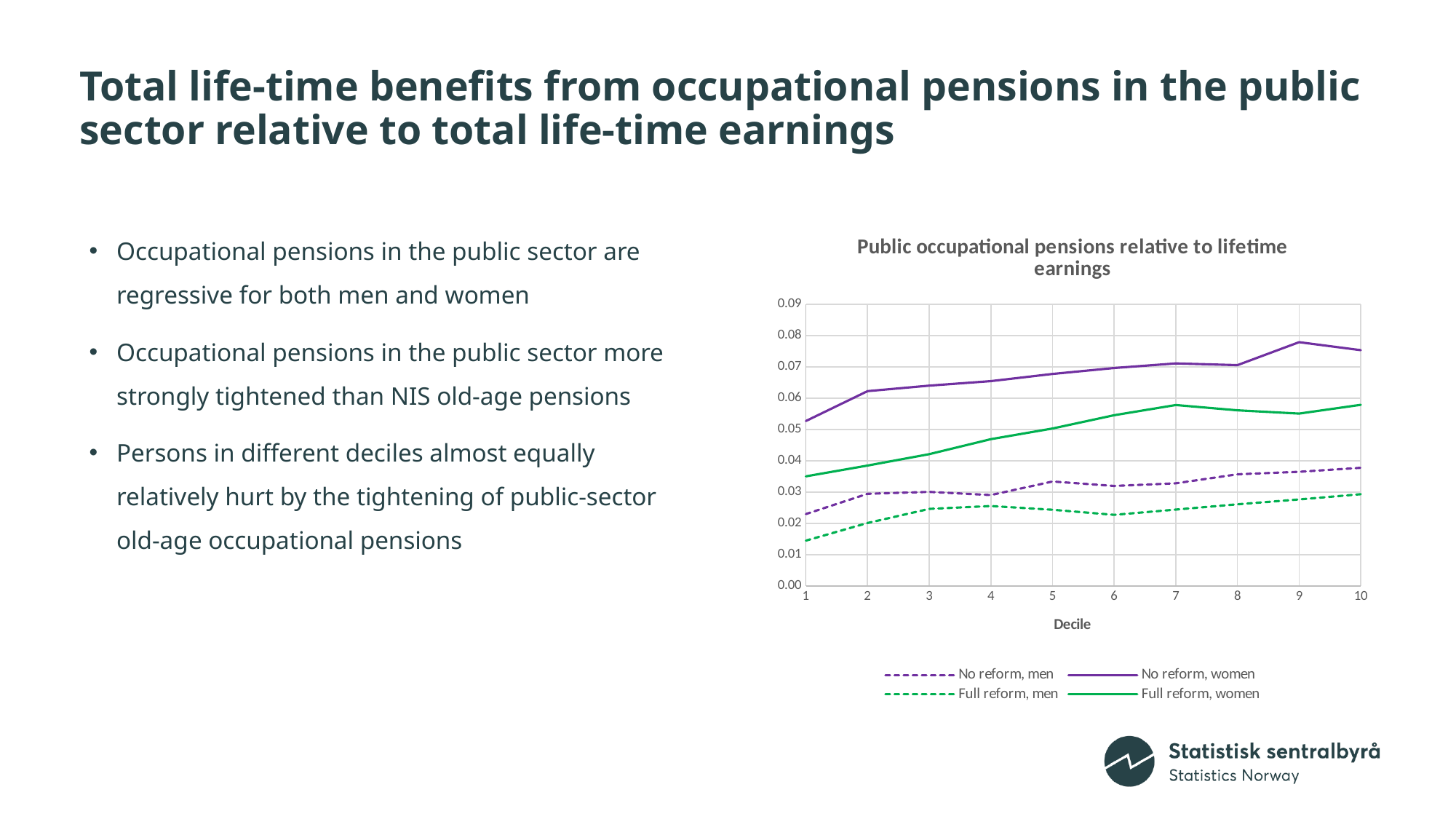
What kind of chart is shown on the slide? Line chart Is the value for 'No reform, women' at decile 9 greater or less than 0.07? greater How many series does the legend of the chart list? 4 How many deciles are plotted along the x axis of the chart? 10 Is the value for 'Full reform, men' at decile 1 greater or less than 0.02? less What is the label of the x axis of the chart? Decile What is the title of the chart? Public occupational pensions relative to lifetime earnings Which series has the lowest values across the deciles? Full reform, men Do the values for 'No reform, women' generally rise or fall from decile 1 to decile 10? Rise At decile 5, which is larger: the value for 'No reform, women' or the value for 'Full reform, women'? No reform, women Which series has the highest values across the deciles? No reform, women Is the value for 'No reform, women' at decile 1 greater or less than 0.05? greater